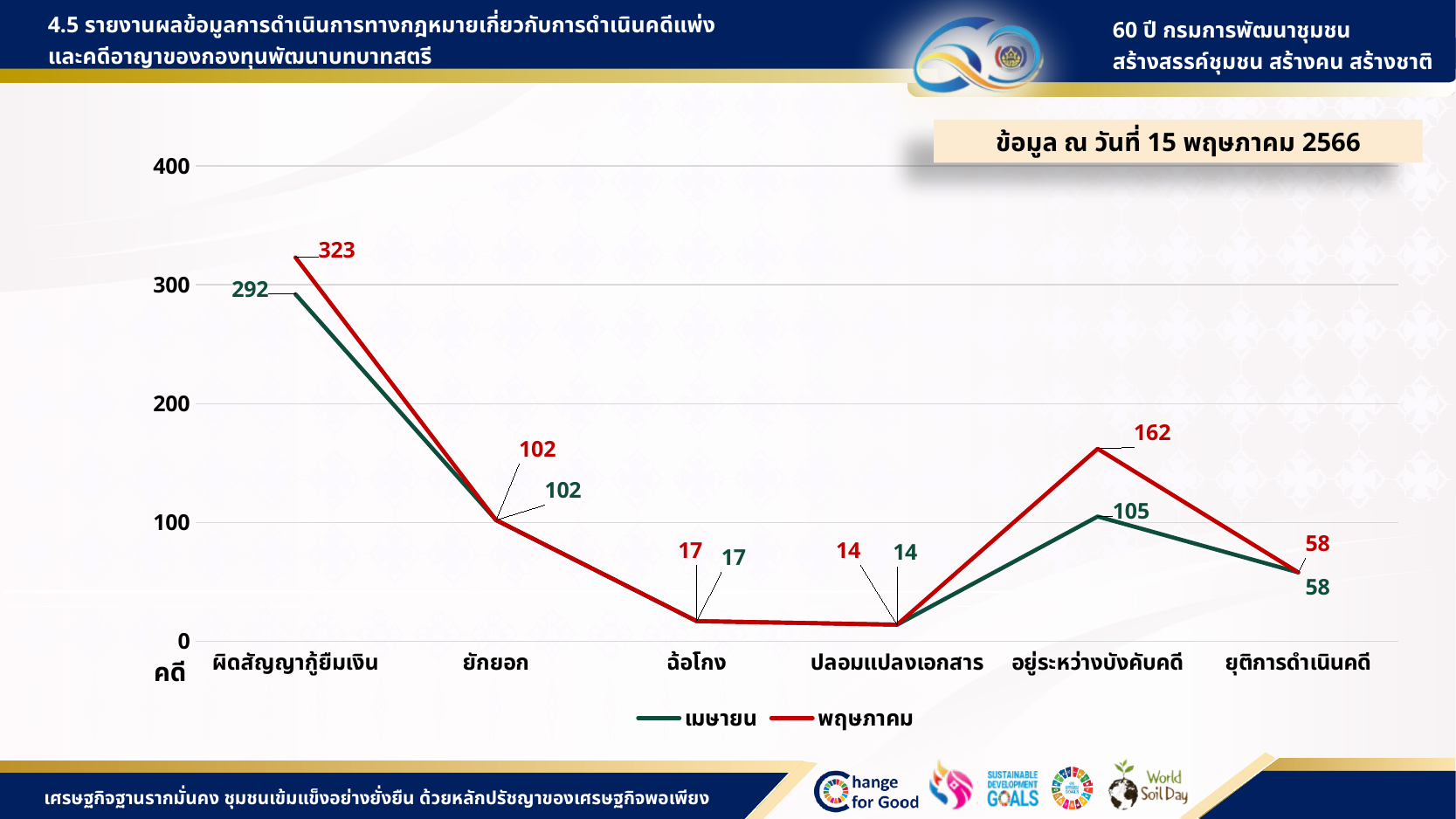
How many series does the legend list? 2 What is the value for ผิดสัญญากู้ยืมเงิน in the เมษายน series? 292 What are the two series names listed in the legend? เมษายน and พฤษภาคม How many categories are shown on the x axis? 6 What is the difference between the พฤษภาคม and เมษายน values for อยู่ระหว่างบังคับคดี? 57 What is the value for อยู่ระหว่างบังคับคดี in the พฤษภาคม series? 162 Which category has the highest value in the พฤษภาคม series? ผิดสัญญากู้ยืมเงิน What type of chart is shown on the slide? line chart What is the value for ยุติการดำเนินคดี in the เมษายน series? 58 For ผิดสัญญากู้ยืมเงิน, which series has the larger value, เมษายน or พฤษภาคม? พฤษภาคม What is the value for ผิดสัญญากู้ยืมเงิน in the พฤษภาคม series? 323 Which category has the lowest value in the เมษายน series? ปลอมแปลงเอกสาร